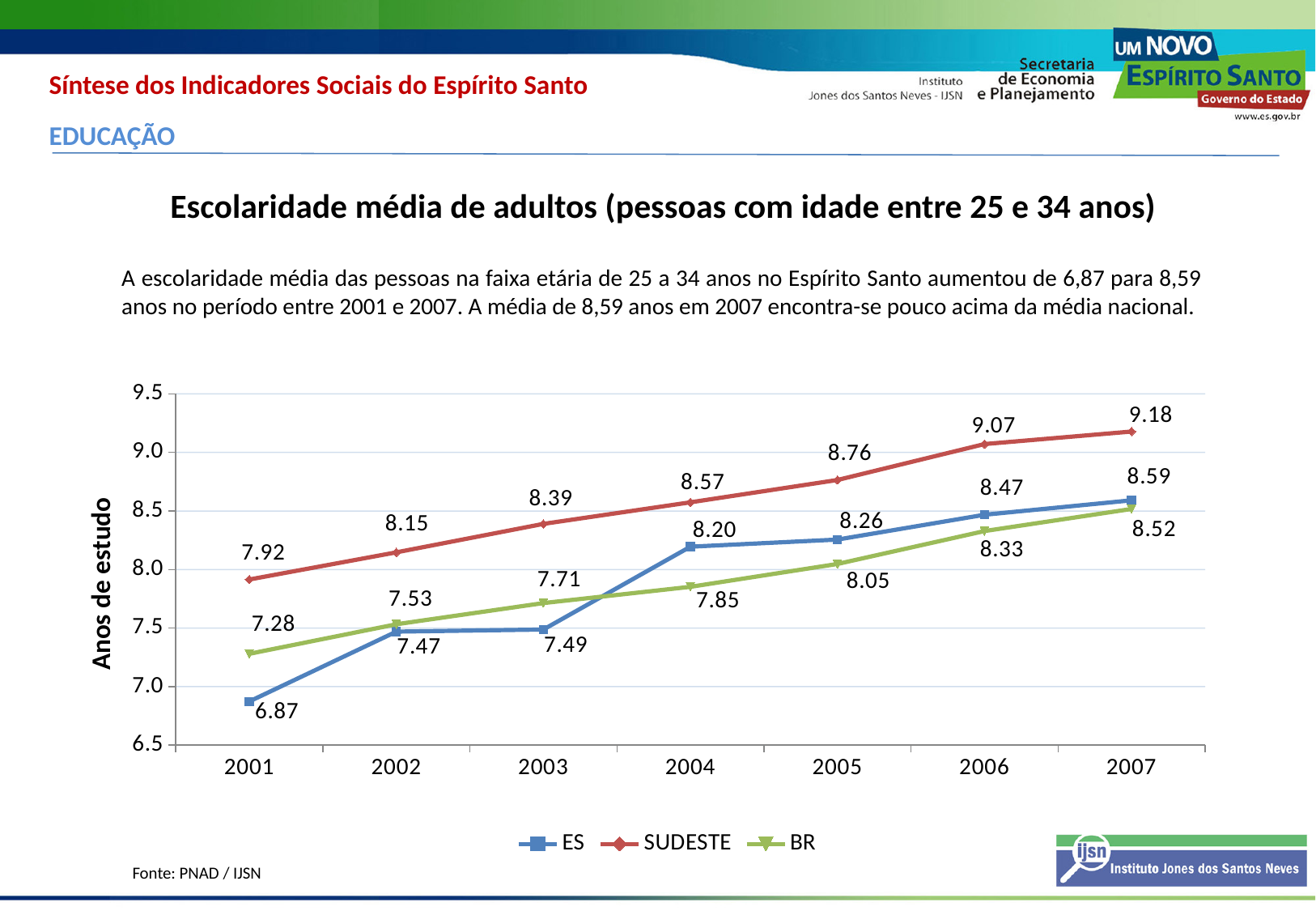
How many years are shown on the x axis? 7 What kind of chart is shown on the slide? line chart What is the value for ES in 2001? 6.87 In which year is the BR series at its lowest value? 2001 Is the value for SUDESTE in 2006 greater or less than 9.0? greater What is the value for SUDESTE in 2007? 9.18 What is the value for BR in 2005? 8.05 Does the SUDESTE series rise or fall from 2001 to 2007? rise What is the difference between the SUDESTE and ES values in 2007? 0.59 In which year does the ES series reach its highest value? 2007 How many series does the legend list? 3 Which is larger in 2003, the value for ES or the value for BR? BR